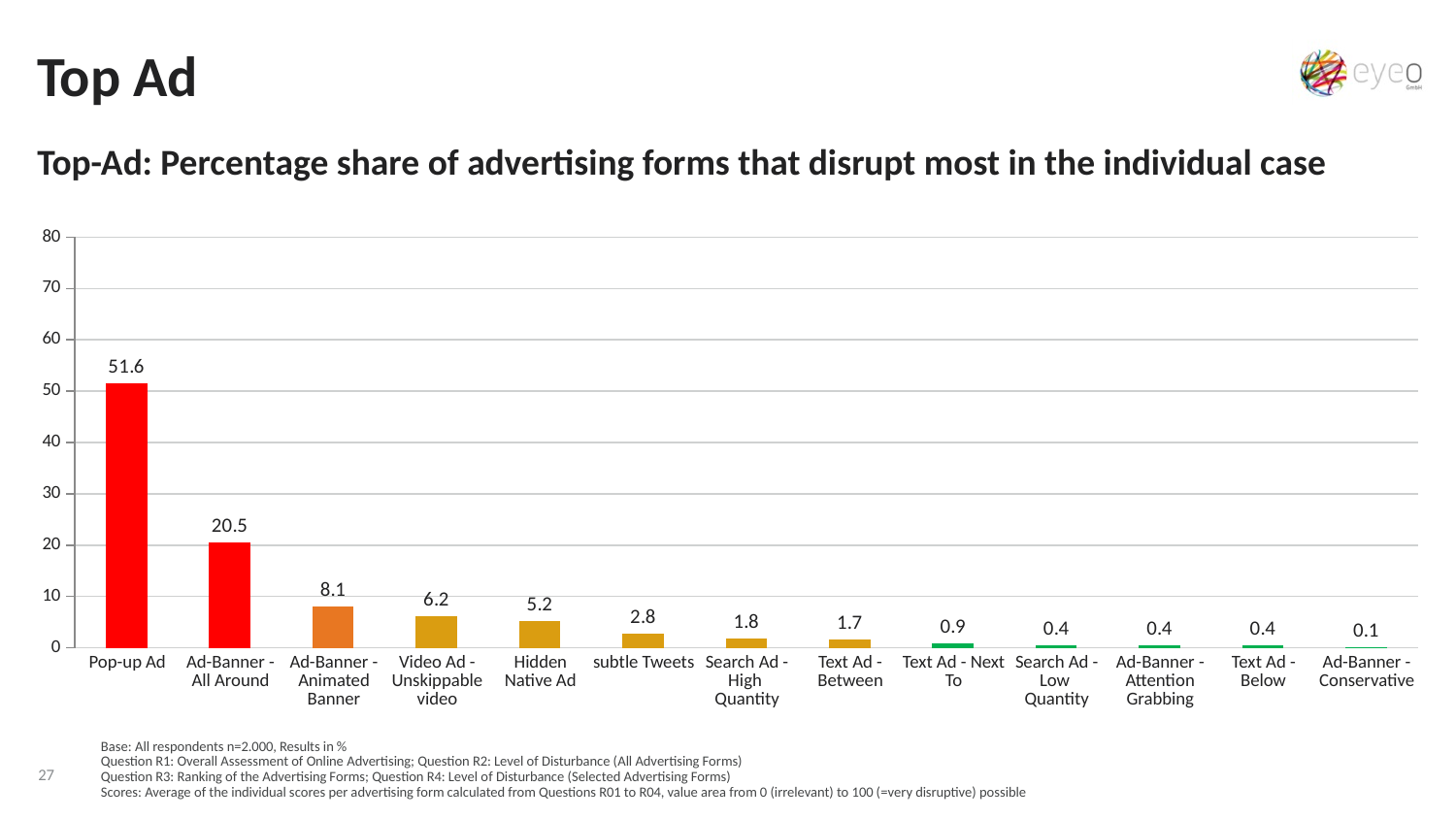
What is the difference between the values for Pop-up Ad and Ad-Banner - All Around? 31.1 What kind of chart is shown on the slide? bar chart Do the values rise or fall from left to right along the x axis? fall Which category has the lowest value? Ad-Banner - Conservative What is the value for subtle Tweets? 2.8 What is the value for Hidden Native Ad? 5.2 How many categories are shown on the x axis? 13 Which is larger, the value for Ad-Banner - Animated Banner or Video Ad - Unskippable video? Ad-Banner - Animated Banner Is the value for Pop-up Ad greater or less than 50? greater Which category has the highest value? Pop-up Ad What is the value for Pop-up Ad? 51.6 What is the value for Ad-Banner - All Around? 20.5